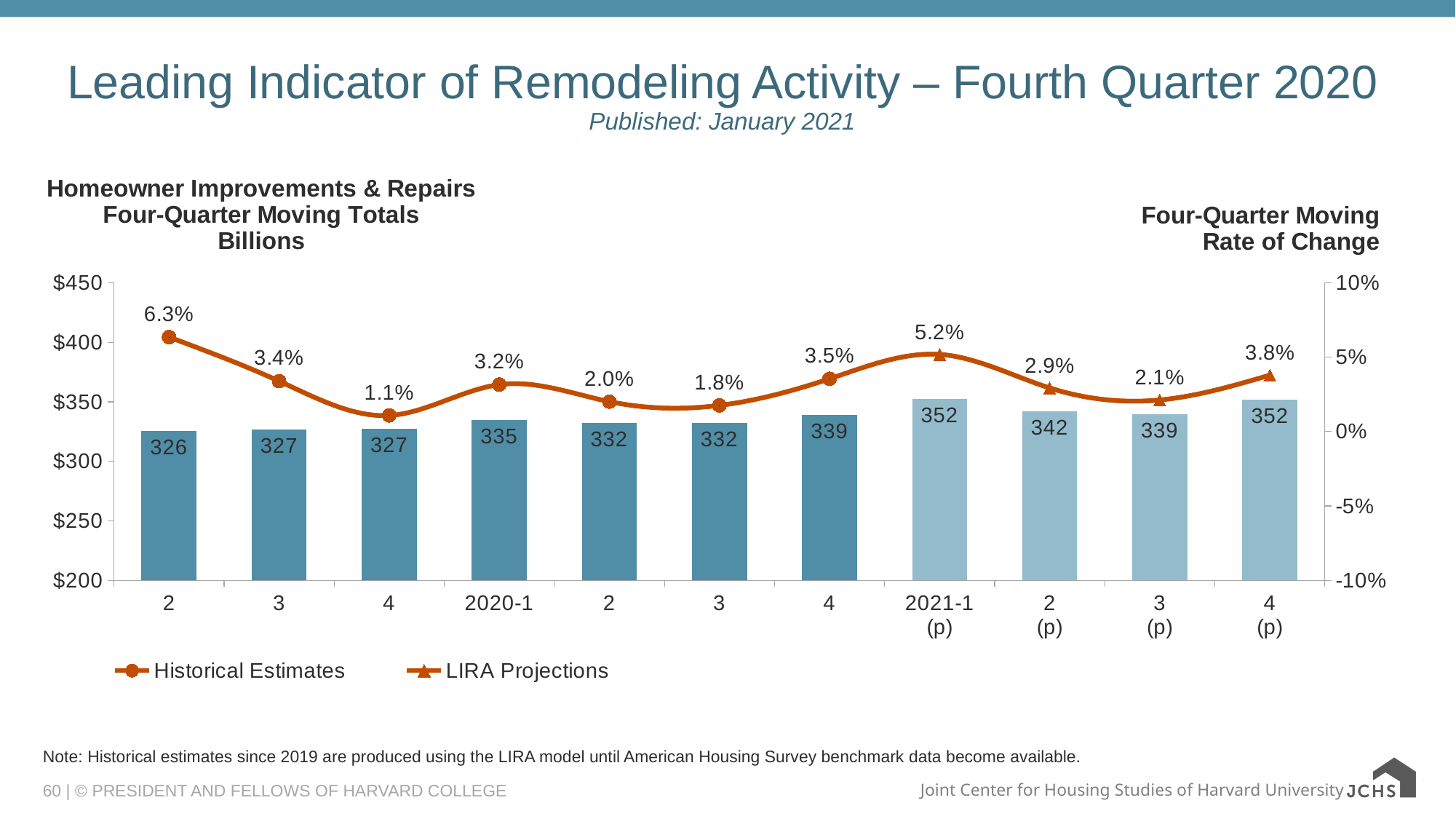
What is the four-quarter moving total (in billions) for 4 (p), the last bar on the chart? 352 Which is larger, the four-quarter moving total for 2 (p) or for 3 (p)? 2 (p) How many quarters (bars) are shown on the chart? 11 What is the four-quarter moving rate of change for 2021-1 (p)? 5.2% What is the difference between the four-quarter moving totals for 2021-1 (p) and 2020-1? 17 What kind of chart is shown on the slide? A combination bar and line chart What is the four-quarter moving total (in billions) for 2020-1? 335 How many series does the legend list? 2 Which quarter has the lowest four-quarter moving rate of change? 4 (1.1%) What are the two series named in the legend? Historical Estimates and LIRA Projections Which quarter has the highest four-quarter moving rate of change? 2 (the first quarter shown, 6.3%) What is the difference between the rate of change for 2021-1 (p) and the rate of change for 2 (p)? 2.3%